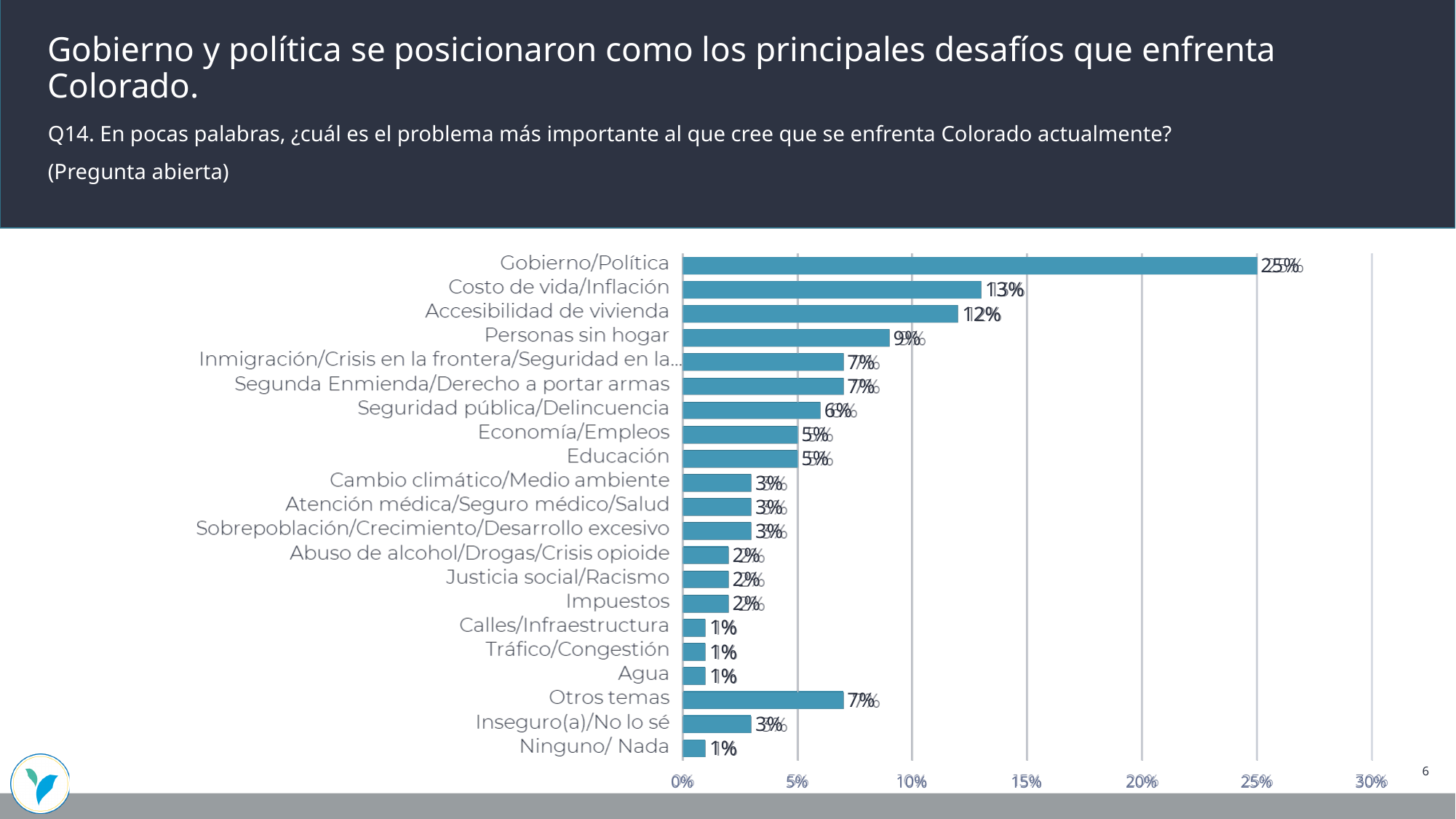
What is the highest value shown on the x axis? 30% Is the value for Accesibilidad de vivienda greater or less than 10%? greater What value is shown for Accesibilidad de vivienda? 12% What value is shown for Otros temas? 7% What value is shown for Costo de vida/Inflación? 13% Which is larger, the value for Seguridad pública/Delincuencia or the value for Educación? Seguridad pública/Delincuencia Which category has the highest value? Gobierno/Política What value is shown for Personas sin hogar? 9% How many categories are shown in the chart? 21 What value is shown for Gobierno/Política? 25% What is the difference between the values for Gobierno/Política and Costo de vida/Inflación? 12% What kind of chart is shown on the slide? bar chart